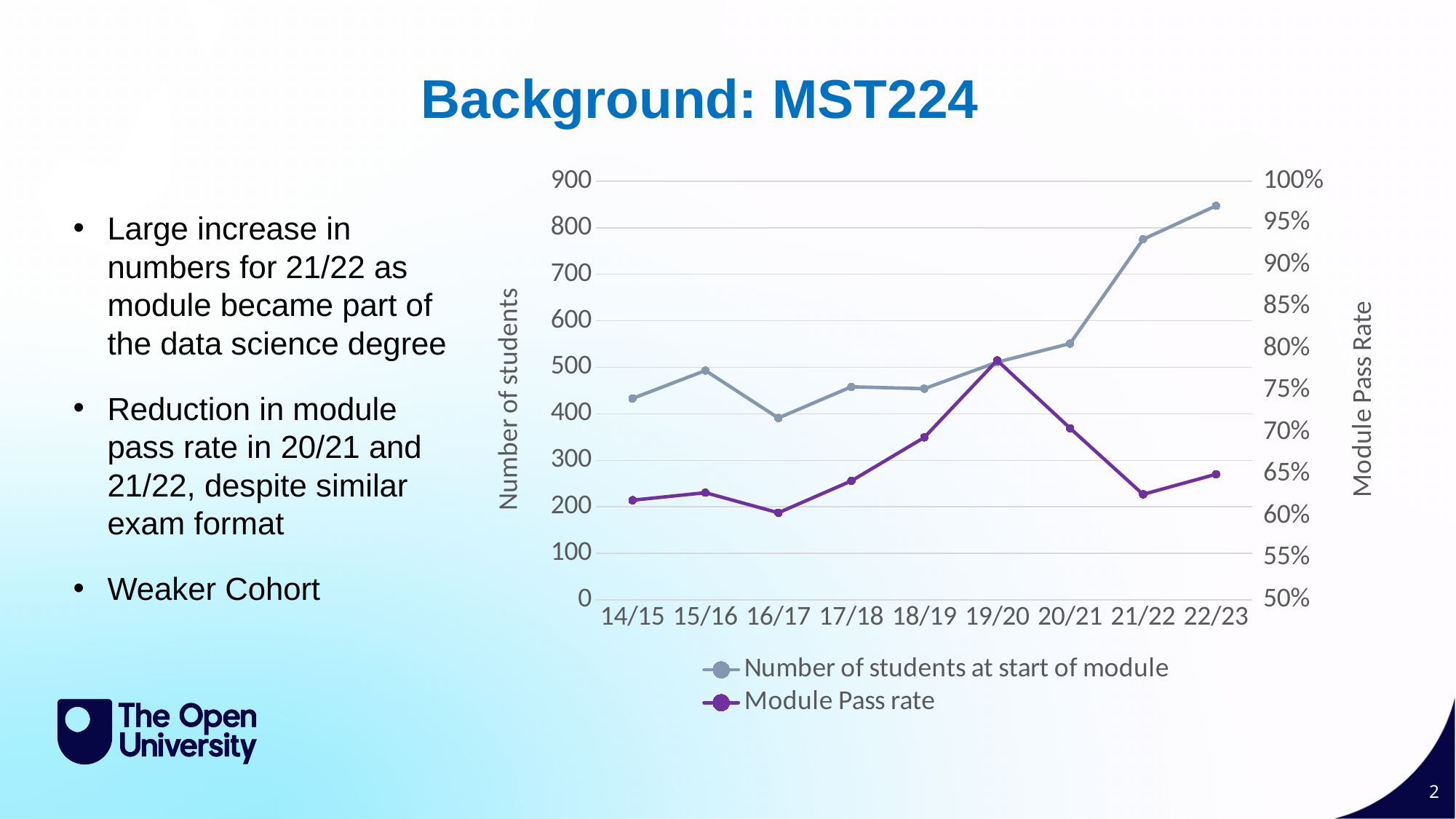
How many series does the chart legend list? 2 Is the module pass rate in 19/20 greater or less than 75%? greater How many academic years are plotted along the x axis? 9 What kind of chart is shown on the slide? line chart Which year has the larger module pass rate, 19/20 or 20/21? 19/20 In which year is the module pass rate highest? 19/20 Does the number of students at start of module rise or fall from 19/20 to 22/23? rise Is the module pass rate in 21/22 greater or less than 65%? less In which year is the number of students at start of module lowest? 16/17 Is the number of students at start of module in 22/23 greater or less than 800? greater In which year is the number of students at start of module highest? 22/23